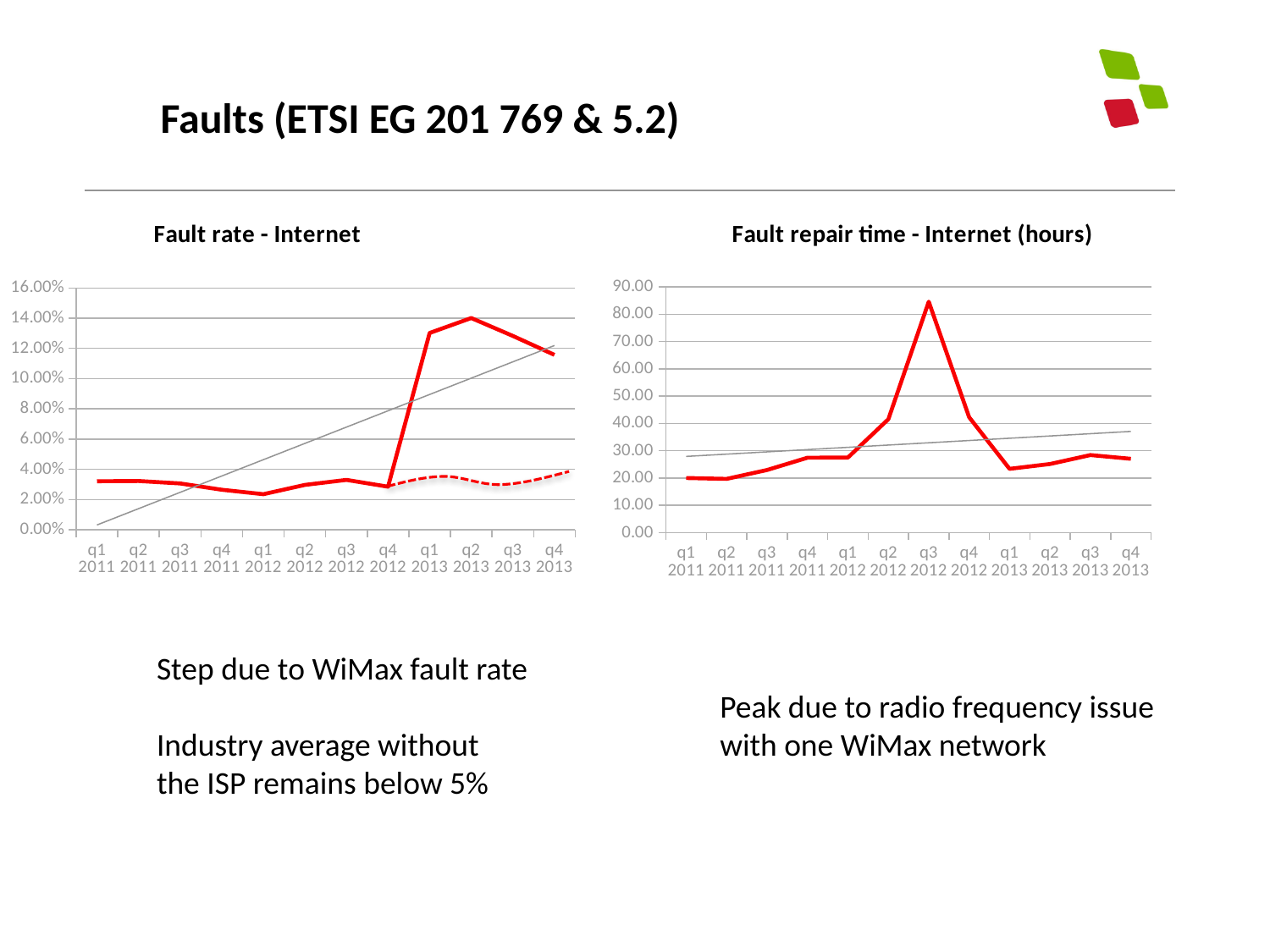
In the 'Fault repair time - Internet (hours)' chart, is the red line's value for q1 2013 greater or less than 30.00? less In the 'Fault rate - Internet' chart, is the solid red line's value for q4 2012 greater or less than 4.00%? less In the 'Fault repair time - Internet (hours)' chart, how many quarters are shown on the x axis? 12 In the 'Fault rate - Internet' chart, in which quarter does the solid red line reach its highest value? q2 2013 In the 'Fault rate - Internet' chart, is the solid red line's value for q1 2013 greater or less than 12.00%? greater In the 'Fault repair time - Internet (hours)' chart, which quarter has the larger red-line value, q3 2012 or q4 2012? q3 2012 What kind of chart is the 'Fault rate - Internet' chart? line chart In the 'Fault rate - Internet' chart, how many quarters are shown on the x axis? 12 What is the title of the chart on the right side of the slide? Fault repair time - Internet (hours) In the 'Fault repair time - Internet (hours)' chart, in which quarter does the red line reach its highest value? q3 2012 What kind of chart is the 'Fault repair time - Internet (hours)' chart? line chart